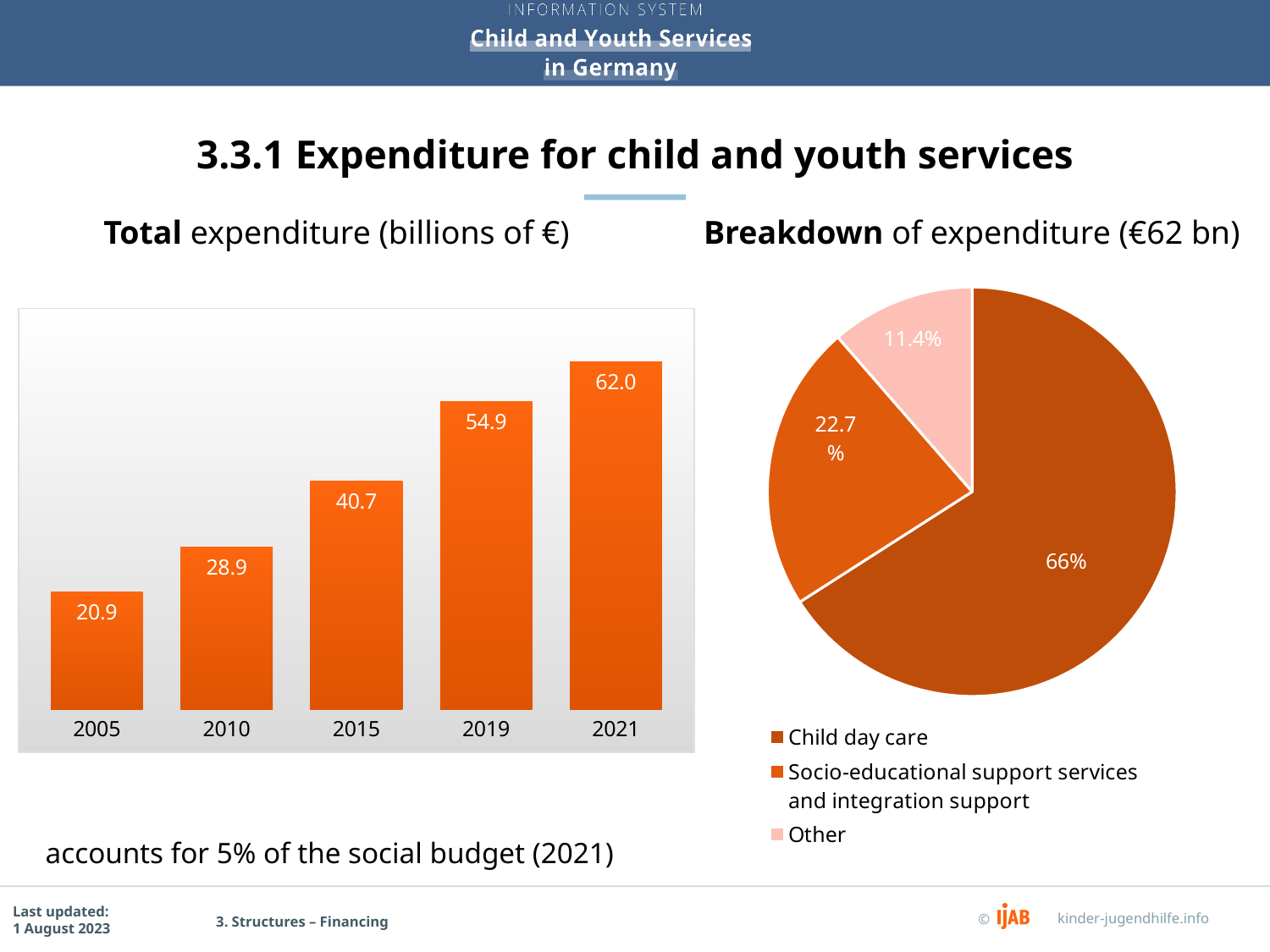
In the 'Total expenditure (billions of €)' bar chart, what is the difference between the values for 2021 and 2019? 7.1 In the 'Total expenditure (billions of €)' bar chart, what is the value for 2015? 40.7 In the 'Total expenditure (billions of €)' bar chart, what is the value for 2005? 20.9 In the 'Total expenditure (billions of €)' bar chart, which year has the highest value? 2021 In the 'Breakdown of expenditure (€62 bn)' pie chart, what share does Child day care have? 66% How many entries does the legend of the 'Breakdown of expenditure (€62 bn)' pie chart list? 3 What kind of chart is the 'Total expenditure (billions of €)' chart? Bar chart In the 'Total expenditure (billions of €)' bar chart, which is larger, the value for 2010 or the value for 2015? 2015 How many years are shown in the 'Total expenditure (billions of €)' bar chart? 5 In the 'Total expenditure (billions of €)' bar chart, do the values rise or fall from 2005 to 2021? Rise In the 'Breakdown of expenditure (€62 bn)' pie chart, what share does Other have? 11.4% In the 'Total expenditure (billions of €)' bar chart, which year has the lowest value? 2005